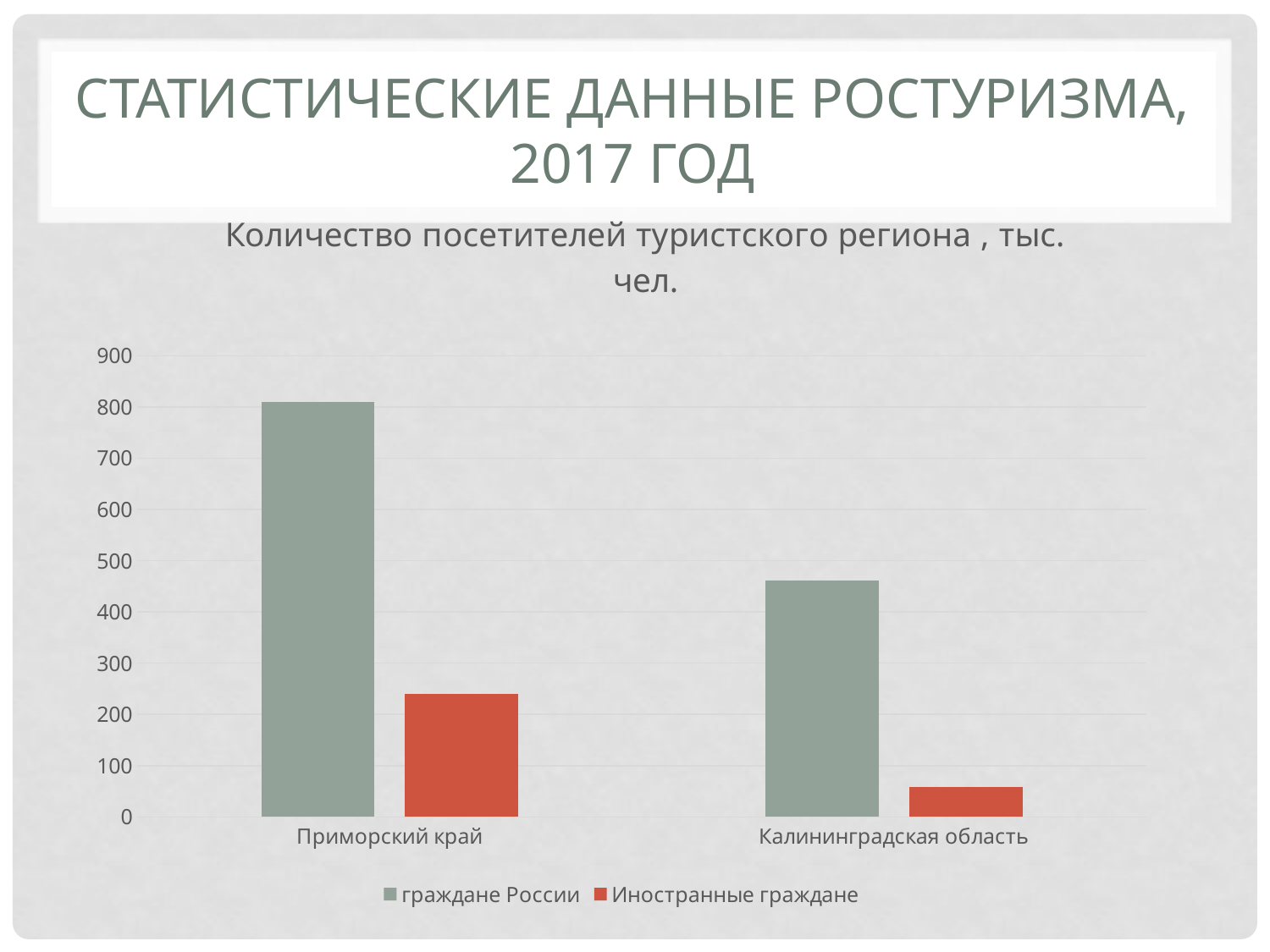
Which region has the higher value for граждане России? Приморский край What kind of chart is shown on the slide? bar chart How many series does the legend list? 2 Is the value for граждане России in Приморский край greater or less than 700? greater Which bar is the highest in the chart? граждане России, Приморский край Is the value for граждане России in Калининградская область greater or less than 400? greater Which series is shown in red/orange bars? Иностранные граждане Is the value for Иностранные граждане in Приморский край greater or less than 300? less How many regions (categories) are shown on the x axis? 2 What is the title of the chart? Количество посетителей туристского региона , тыс. чел. Which bar is the lowest in the chart? Иностранные граждане, Калининградская область